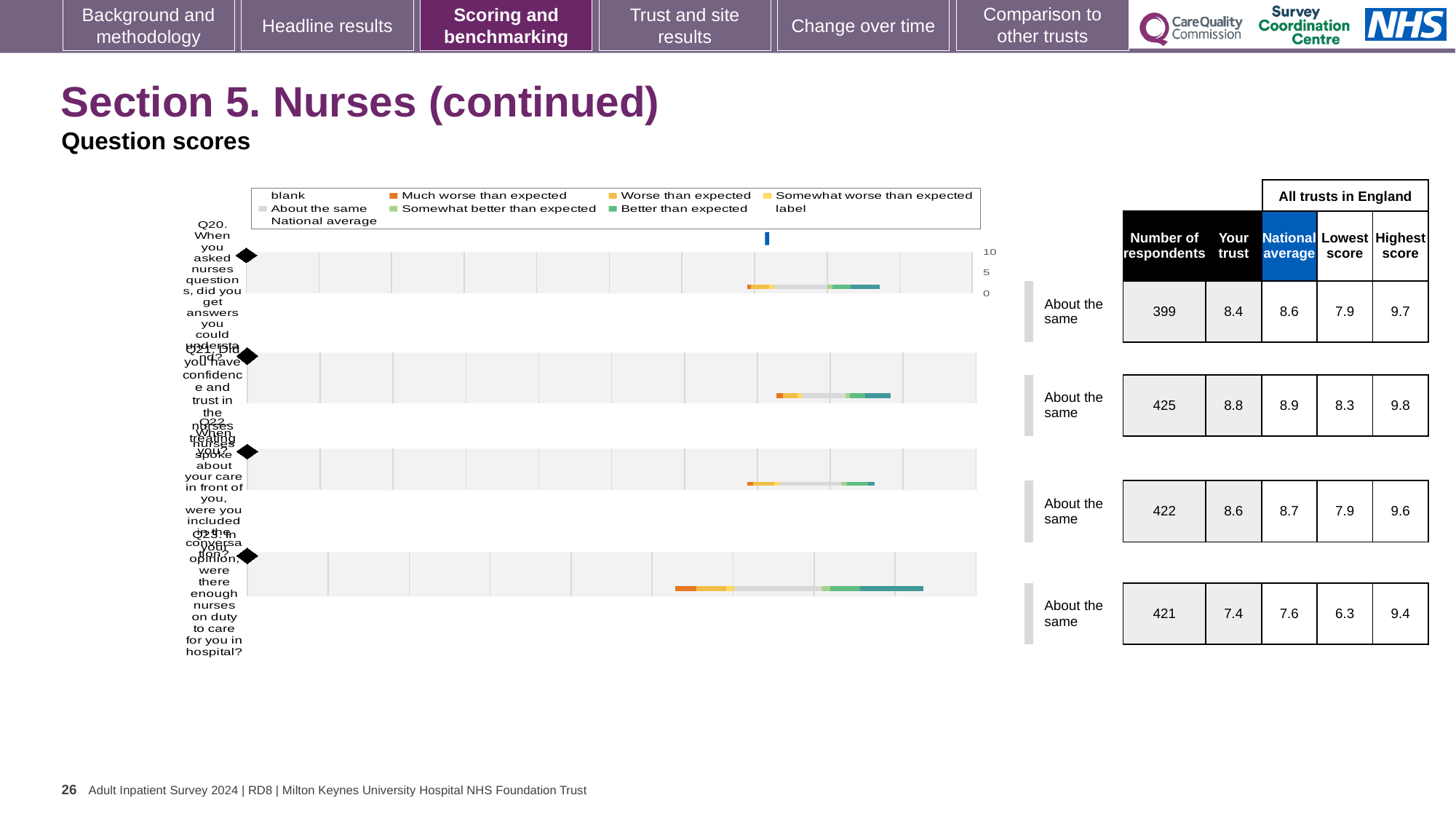
What benchmark category is shown beside the Q22 chart? About the same In the table next to the Q20 chart, how many respondents are listed? 399 In the table next to the Q23 chart, what is the 'Your trust' score? 7.4 For Q23, what is the difference between the national average and the 'Your trust' score? 0.2 What does the blue marker in the chart legend represent? National average Which question (Q20 to Q23) has the lowest 'Your trust' score in the table? Q23 Which question (Q20 to Q23) has the highest 'Your trust' score in the table? Q21 For Q21, which is larger: the 'Your trust' score or the national average? National average How many question charts (Q20 to Q23) are shown on the slide? 4 Which legend entry is shown in grey in the question score charts? About the same In the table next to the Q21 chart, what is the highest score among all trusts in England? 9.8 What kind of chart is used to show the question scores for Q20 to Q23? bar chart